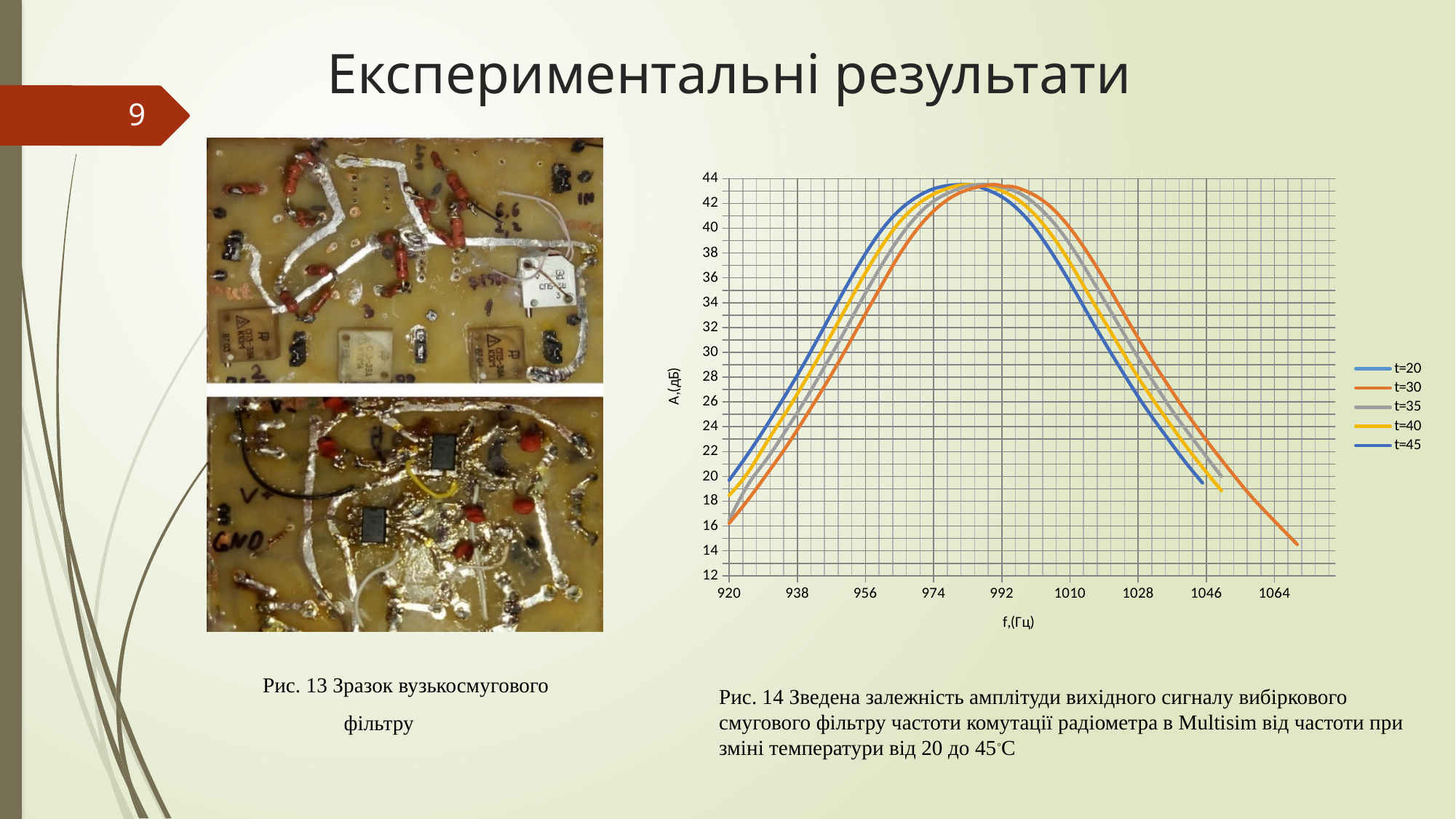
What kind of chart is shown in Рис. 14? line chart At f=956, which series has the larger value, t=45 or t=30? t=45 How many tick labels are shown on the x axis of the chart? 9 What are the series names listed in the chart legend? t=20, t=30, t=35, t=40, t=45 Is the peak value of the t=45 series greater or less than 42? greater What is the label of the chart's x axis? f,(Гц) Is the value of the t=45 series at f=920 greater or less than 18? greater How many series does the legend of the chart list? 5 Which series extends furthest to the right along the frequency axis? t=30 At f=1028, which series has the larger value, t=30 or t=45? t=30 Is the value of the t=30 series at f=920 greater or less than 18? less